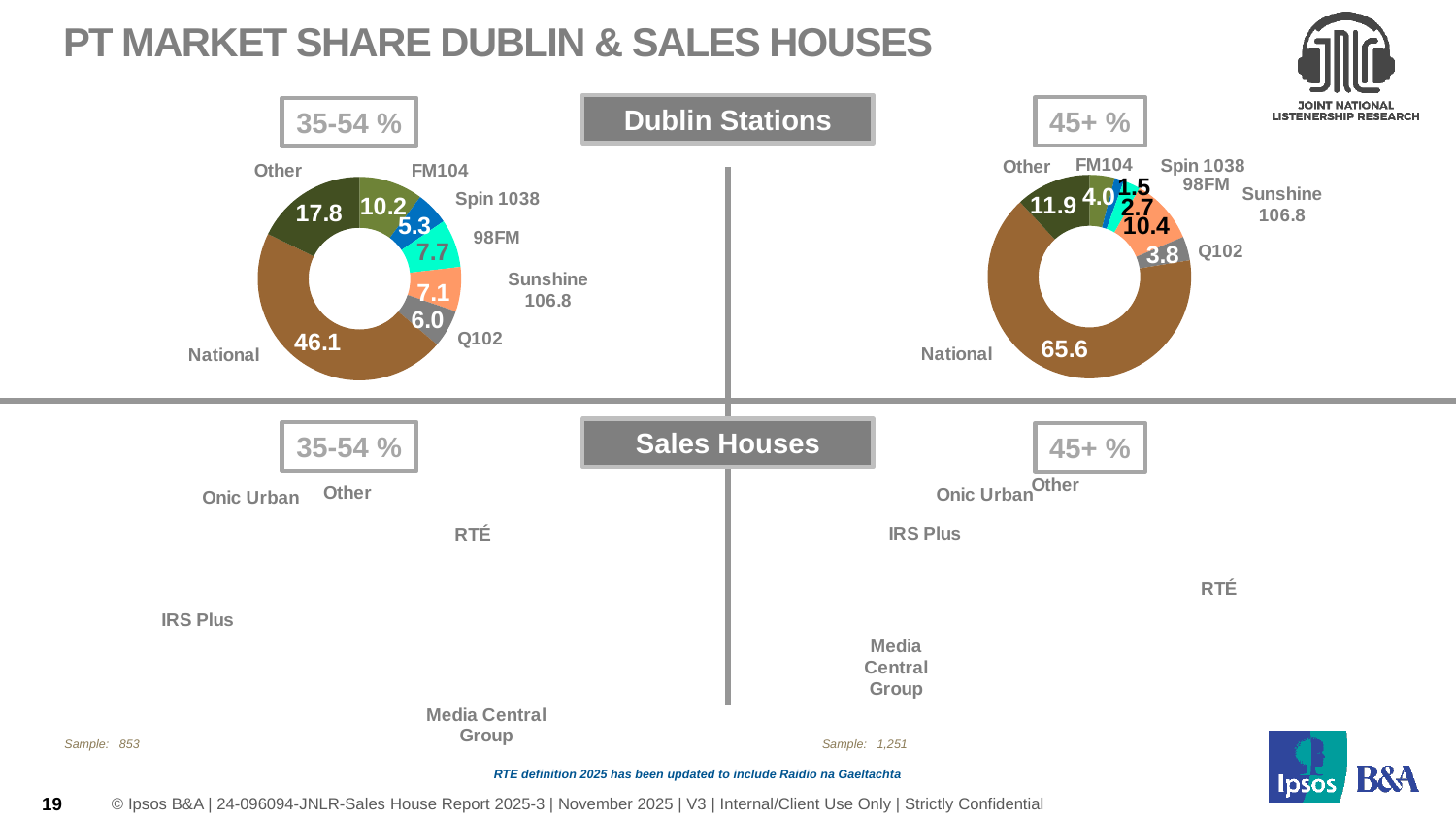
In the Dublin Stations 45+ % chart, what is the difference between the values for National and Other? 53.7 In the Dublin Stations 35-54 % chart, which category has the smallest share? Spin 1038 In the Dublin Stations 35-54 % chart, which is larger, the value for 98FM or the value for Q102? 98FM In the Dublin Stations 35-54 % chart, what is the value for National? 46.1 In the Dublin Stations 45+ % chart, what is the value for Sunshine 106.8? 10.4 In the Dublin Stations 35-54 % chart, what is the value for 98FM? 7.7 In the Dublin Stations 45+ % chart, which category has the largest share? National What kind of chart is used for the Dublin Stations 45+ % data? Donut (pie) chart In the Dublin Stations 45+ % chart, which category has the smallest share? Spin 1038 In the Dublin Stations 35-54 % chart, what is the difference between the values for Other and FM104? 7.6 In the Dublin Stations 45+ % chart, what is the value for FM104? 4.0 How many categories are shown in the Dublin Stations 35-54 % chart? 7